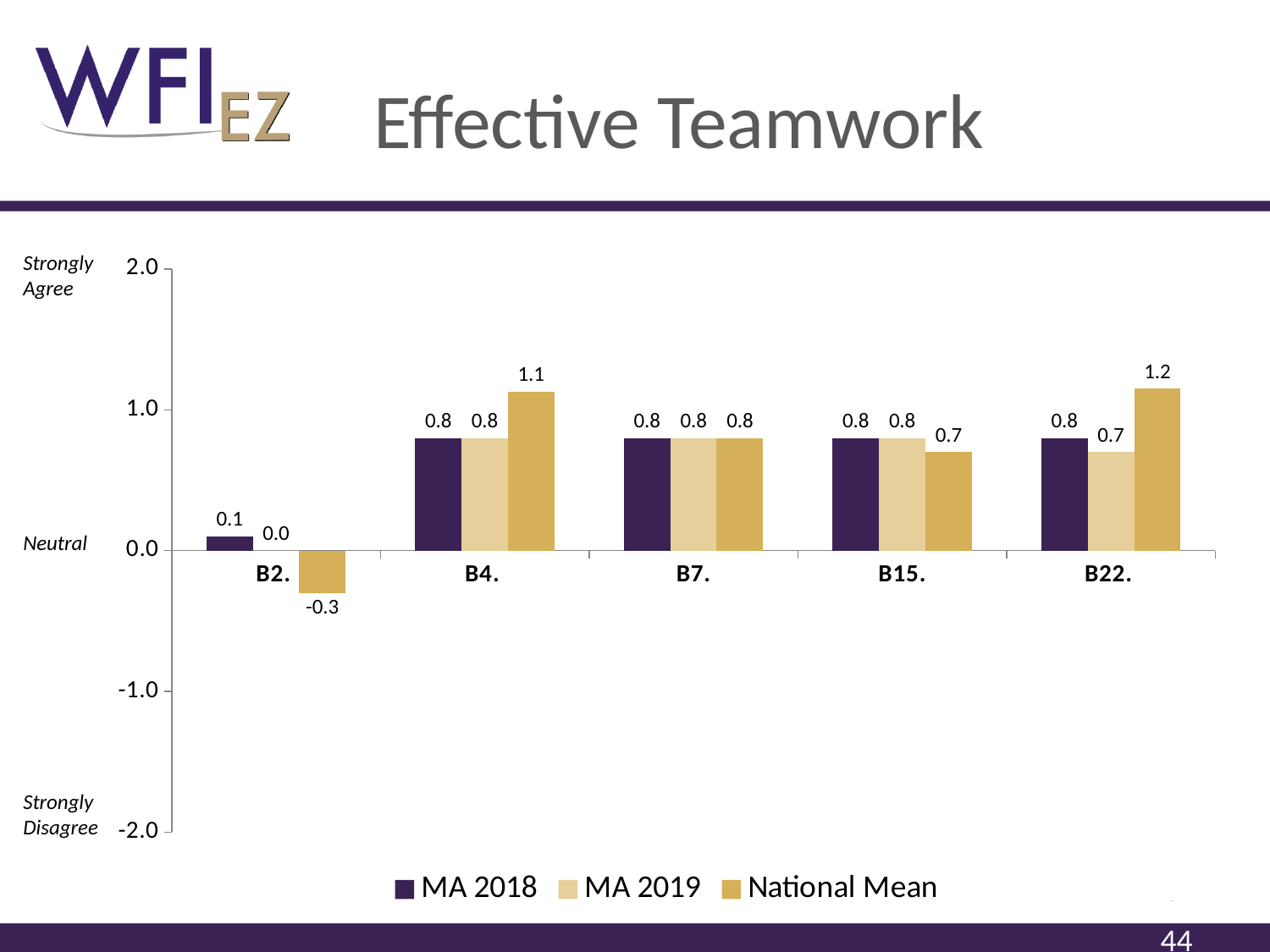
How many series does the legend list? 3 What is the National Mean value for B22.? 1.2 What is the National Mean value for B2.? -0.3 How many categories are shown on the x axis? 5 What is the difference between the National Mean and MA 2019 values for B22.? 0.5 What is the title of the slide? Effective Teamwork What kind of chart is shown on the slide? Bar chart What is the MA 2018 value for B4.? 0.8 Which category has the highest National Mean value? B22. Which category has the lowest MA 2018 value? B2. What is the MA 2019 value for B2.? 0.0 Which is larger for B15., the MA 2019 value or the National Mean value? MA 2019